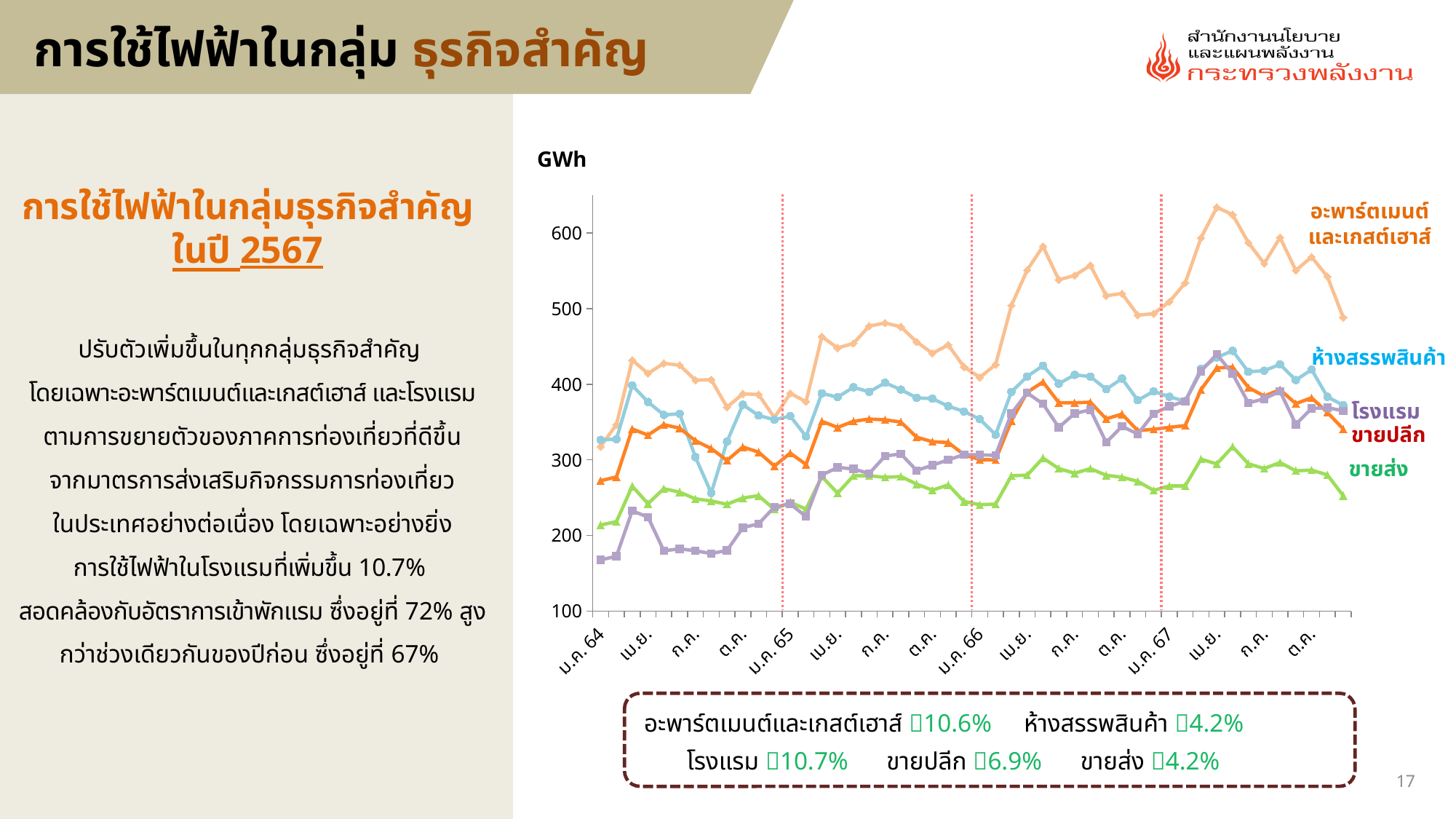
What kind of chart is shown on the slide? line chart Does the โรงแรม series rise or fall overall from ม.ค. 64 to ม.ค. 67? rise Which series has the highest values throughout the chart? อะพาร์ตเมนต์และเกสต์เฮาส์ How many series are plotted in the chart? 5 Is the value for ขายส่ง at ม.ค. 64 greater or less than 300? less Which series has the lowest value at the last point of the chart? ขายส่ง At ม.ค. 64, which is larger: ห้างสรรพสินค้า or ขายปลีก? ห้างสรรพสินค้า What unit is shown on the y axis of the chart? GWh Is the peak value of อะพาร์ตเมนต์และเกสต์เฮาส์ in 2567 greater or less than 600? greater Is the value for โรงแรม at ม.ค. 64 greater or less than 200? less Which series has the lowest value at ม.ค. 64? โรงแรม